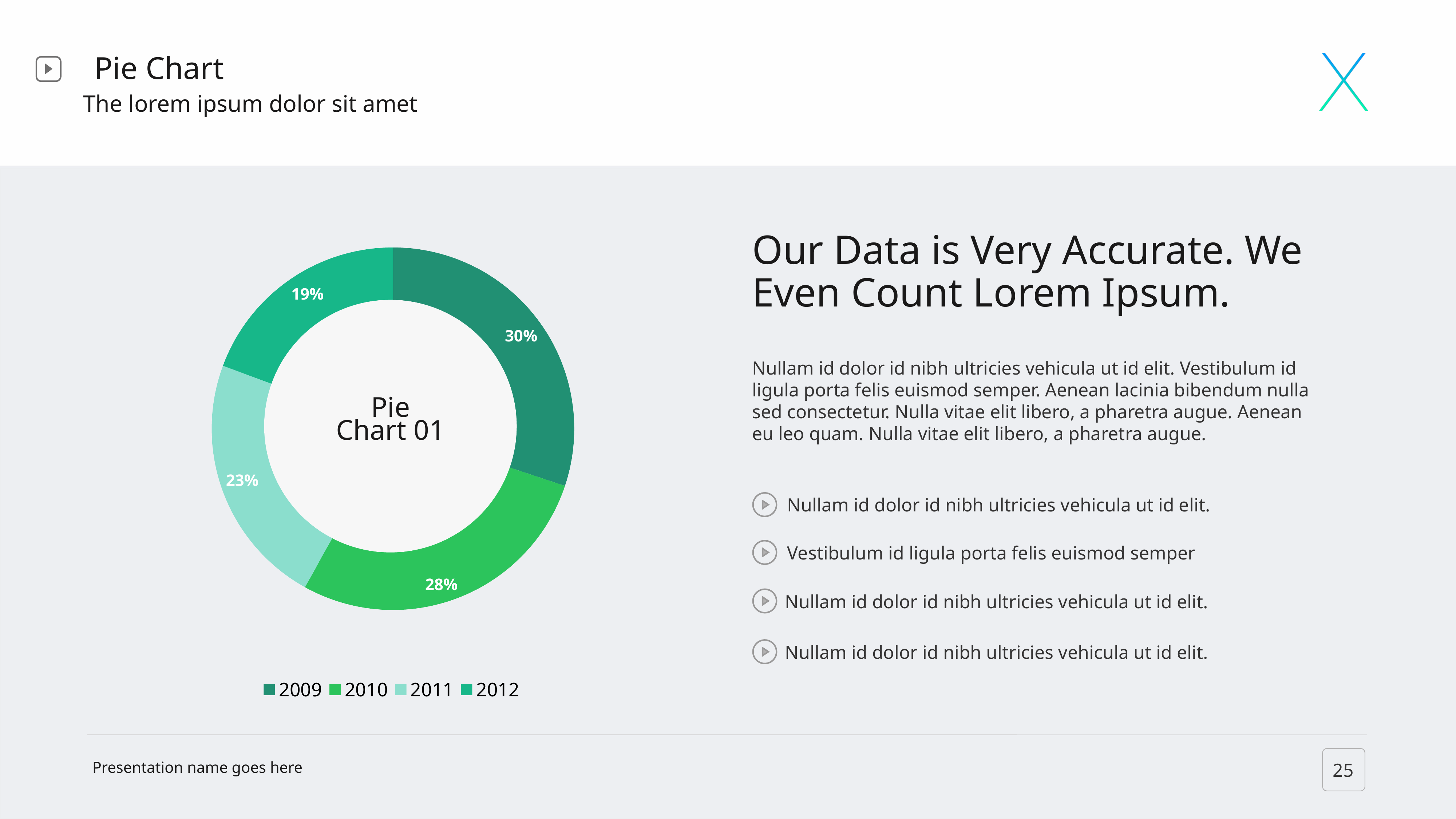
What kind of chart is shown on the slide? Pie chart How many entries does the legend list? 4 Which slice is larger, 2010 or 2011? 2010 What is the difference in percentage points between the 2009 and 2012 slices? 11 How many slices does the pie chart have? 4 What percentage does the 2010 slice represent? 28% What percentage does the 2011 slice represent? 23% Which year has the smallest share of the pie? 2012 Which year has the largest share of the pie? 2009 What text appears in the centre of the pie chart? Pie Chart 01 What percentage does the 2012 slice represent? 19% What percentage does the 2009 slice represent? 30%